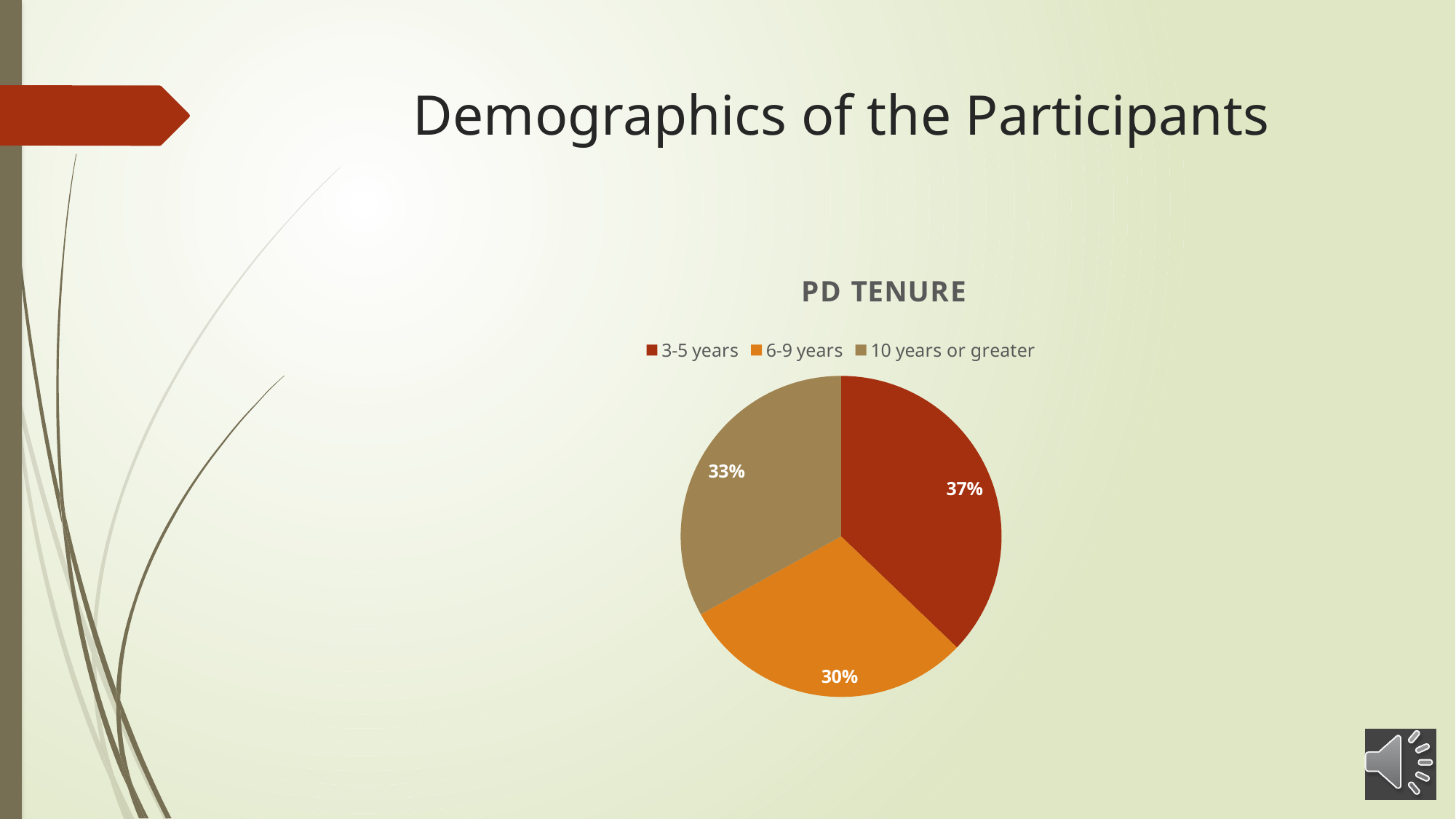
What is the title of the chart? PD TENURE What percentage of participants have 3-5 years of PD tenure? 37% Which is larger, the share for 10 years or greater or the share for 6-9 years? 10 years or greater What is the difference in percentage points between the 3-5 years slice and the 6-9 years slice? 7 What colour is the slice for 6-9 years? orange How many entries does the legend list? 3 What percentage of participants have 10 years or greater of PD tenure? 33% How many categories does the pie chart show? 3 Which PD tenure category has the largest share? 3-5 years Which PD tenure category has the smallest share? 6-9 years What percentage of participants have 6-9 years of PD tenure? 30% What kind of chart is shown on the slide? pie chart